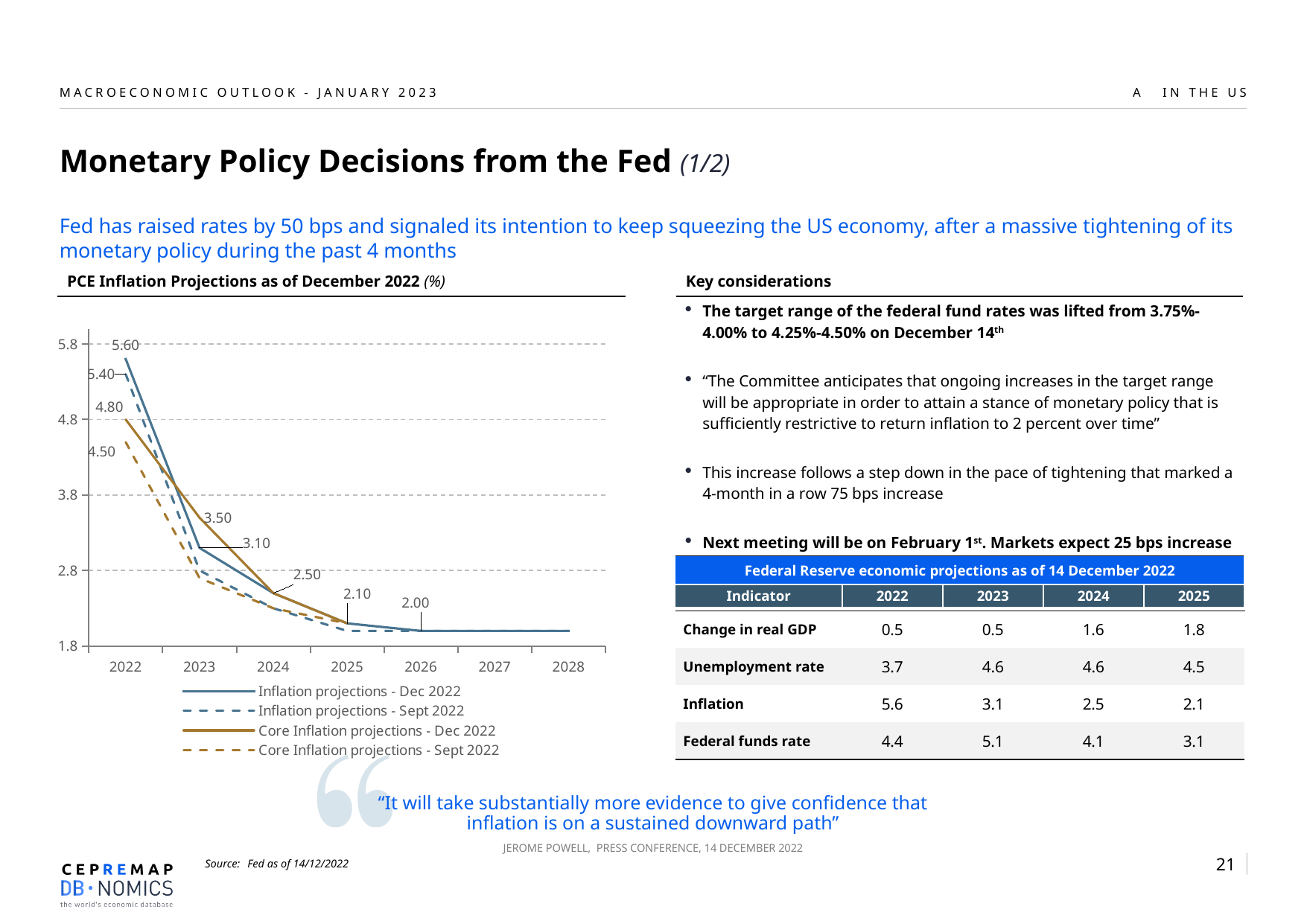
What is the difference between the 2022 values of the Inflation projections - Dec 2022 and Inflation projections - Sept 2022 series? 0.20 What is the value of the Inflation projections - Dec 2022 series for 2023? 3.10 What is the value of the Inflation projections - Sept 2022 series for 2022? 5.40 What is the value of the Core Inflation projections - Dec 2022 series for 2023? 3.50 How many series does the legend of the PCE Inflation Projections chart list? 4 What is the value of the Inflation projections - Dec 2022 series for 2022? 5.60 What is the value of the Core Inflation projections - Dec 2022 series for 2022? 4.80 What is the value of the Core Inflation projections - Sept 2022 series for 2022? 4.50 What kind of chart is shown on the slide? Line chart Is the value of the Inflation projections - Dec 2022 series for 2028 greater or less than 2.8? less How many years are shown on the x axis of the chart? 7 Do the values of the Inflation projections - Dec 2022 series rise or fall from 2022 to 2028? Fall